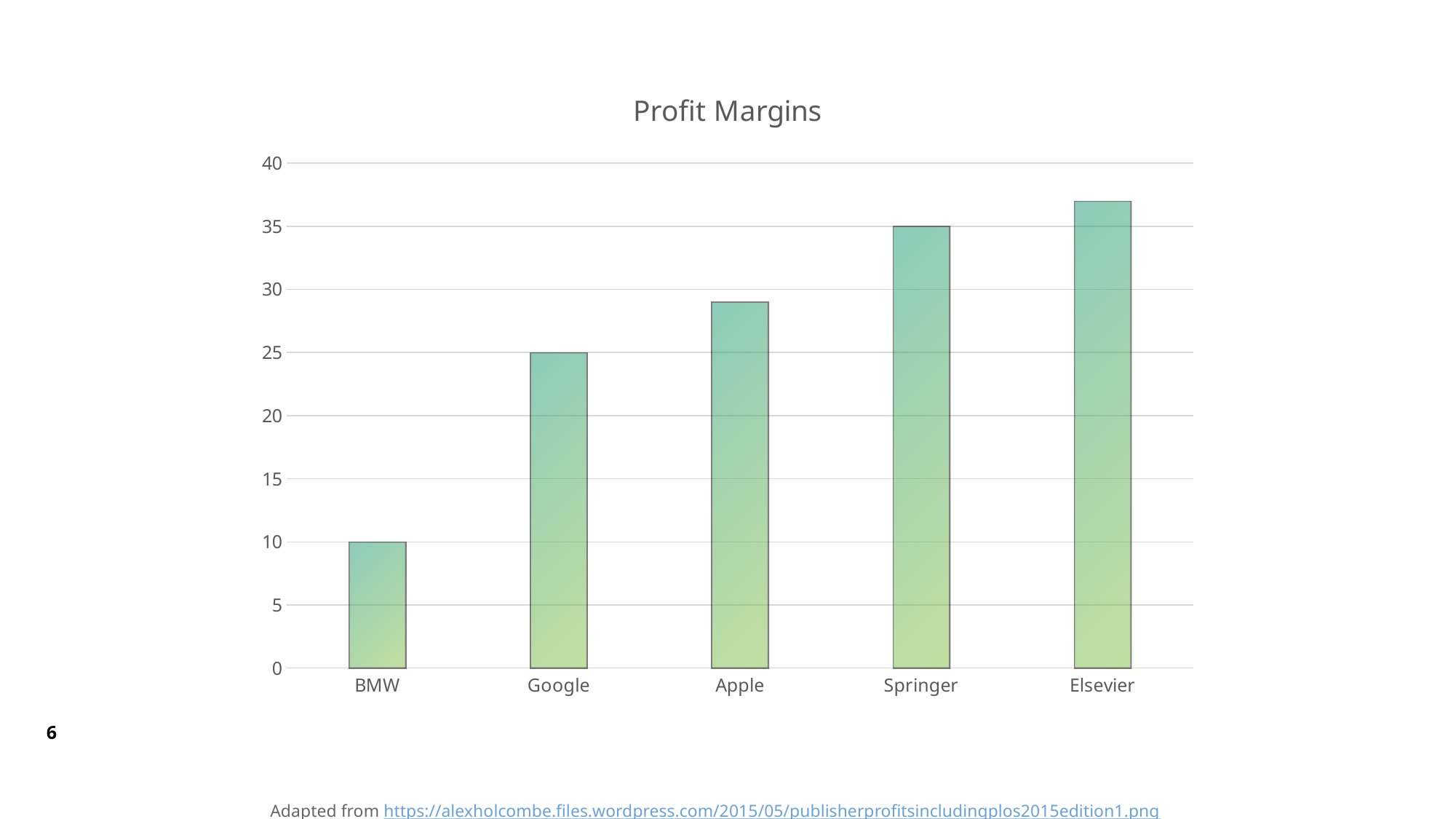
How many categories are shown on the x axis? 5 What is the difference between the values for Google and BMW? 15 Which category has the lowest value? BMW Which is larger, the value for Apple or the value for Google? Apple Is the value for Apple greater or less than 30? less Which category has the highest value? Elsevier What is the value for Google? 25 Is the value for Elsevier greater or less than 35? greater What is the value for BMW? 10 What is the difference between the values for Springer and Google? 10 What is the value for Springer? 35 What kind of chart is this? bar chart